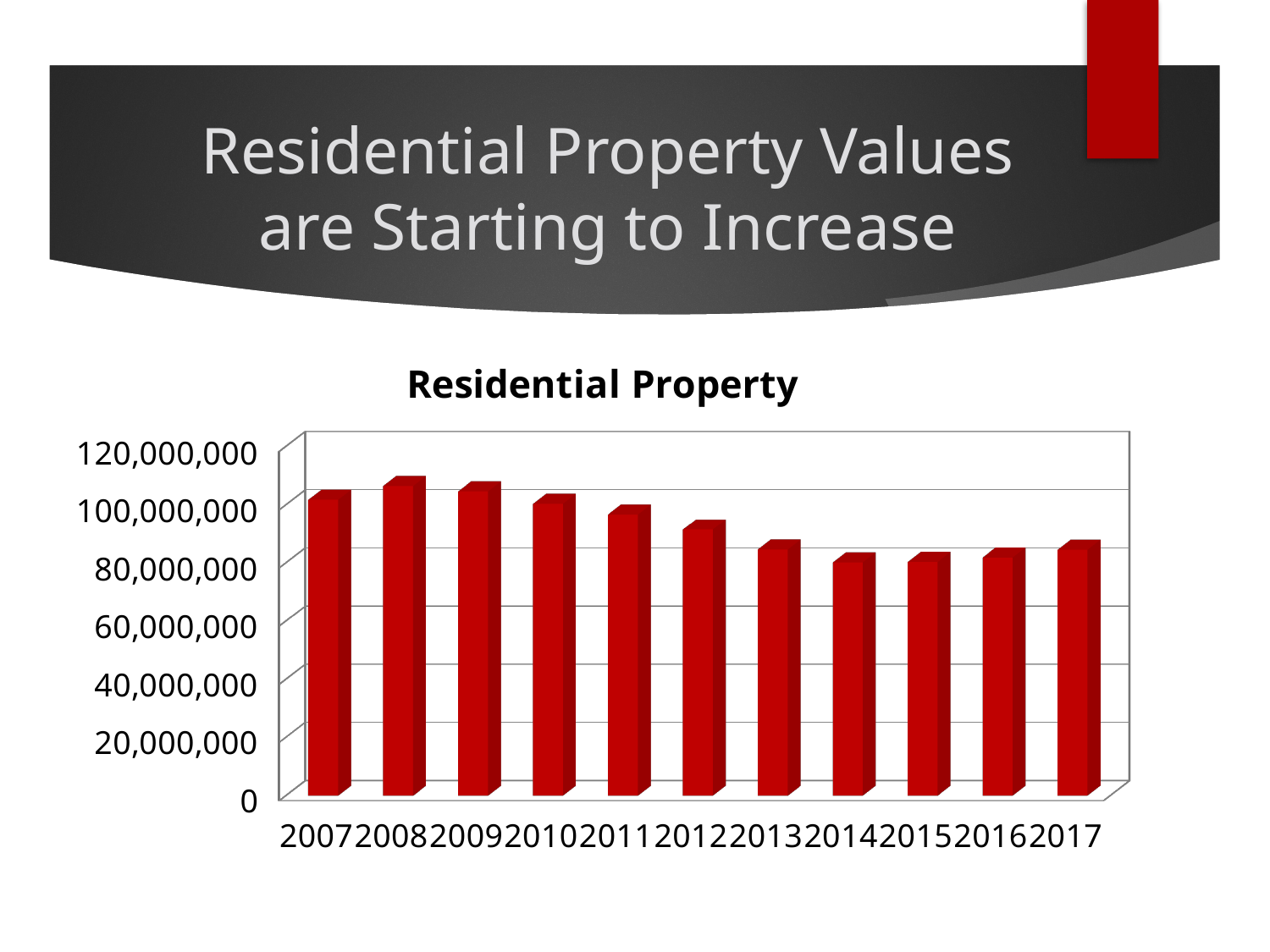
What type of chart is shown on the slide? Bar chart Is the value for 2008 greater or less than 100,000,000? greater Which year has the highest residential property value? 2008 Which is larger, the value for 2012 or the value for 2013? 2012 How many years are shown on the x axis of the chart? 11 Do the values generally rise or fall from 2007 to 2014? Fall Is the value for 2017 greater or less than 100,000,000? less Which is larger, the value for 2007 or the value for 2017? 2007 Is the value for 2012 greater or less than 100,000,000? less What colour are the bars in the chart? Red What is the title of the chart? Residential Property